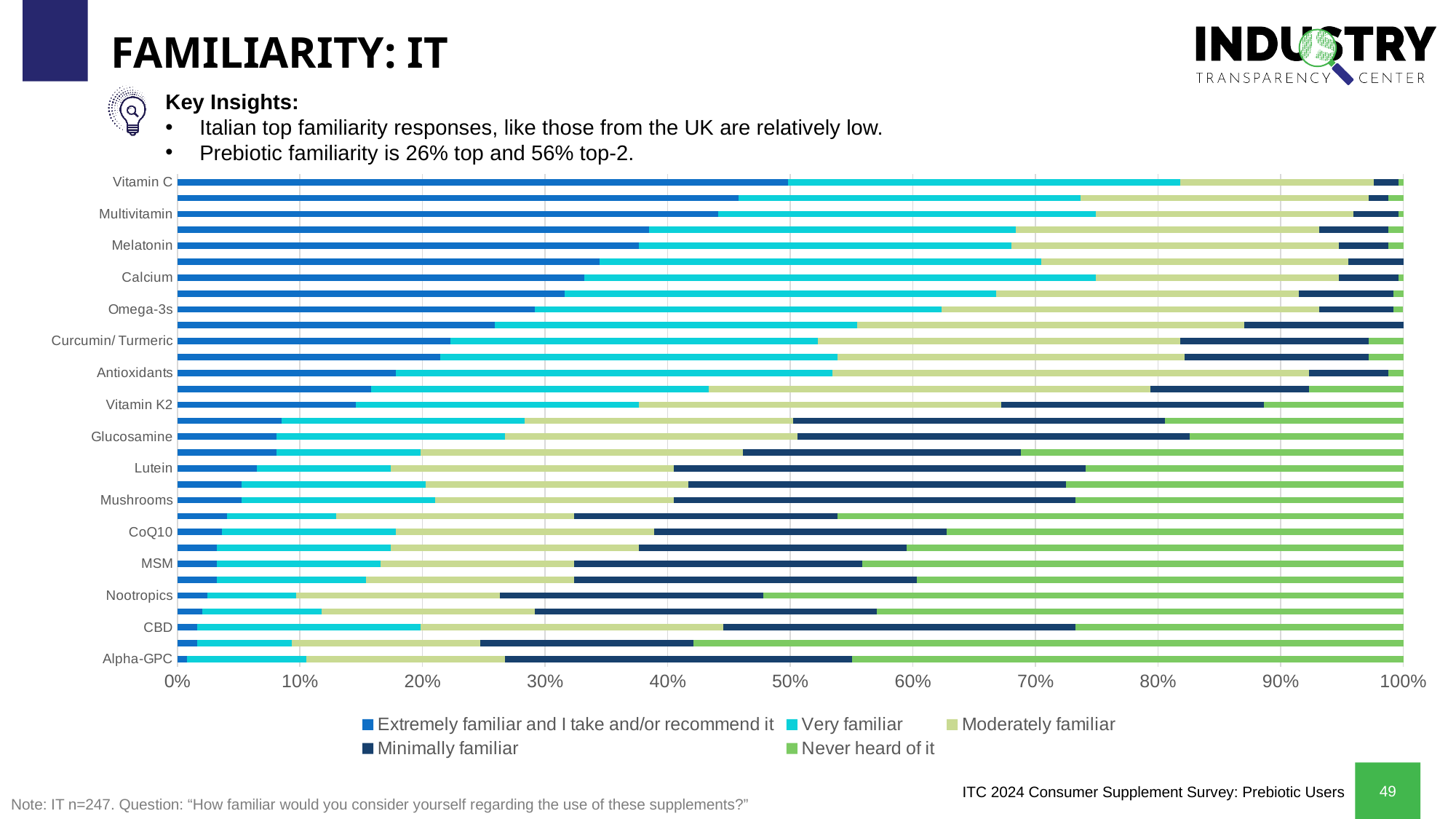
Is the 'Extremely familiar and I take and/or recommend it' value for Vitamin C greater or less than 40%? greater Is the 'Extremely familiar and I take and/or recommend it' value for Glucosamine greater or less than 10%? less Which has a larger 'Extremely familiar and I take and/or recommend it' segment, Vitamin C or Multivitamin? Vitamin C Which labeled supplement has the smallest 'Extremely familiar and I take and/or recommend it' segment? Alpha-GPC Is the 'Never heard of it' value for Alpha-GPC greater or less than 40%? greater Which has a larger 'Never heard of it' segment, Nootropics or CBD? Nootropics Which labeled supplement has the largest 'Never heard of it' segment? Nootropics What is the maximum value shown on the x axis? 100% How many series does the legend list? 5 What kind of chart is shown on the slide? Stacked bar chart Which labeled supplement has the largest 'Extremely familiar and I take and/or recommend it' segment? Vitamin C